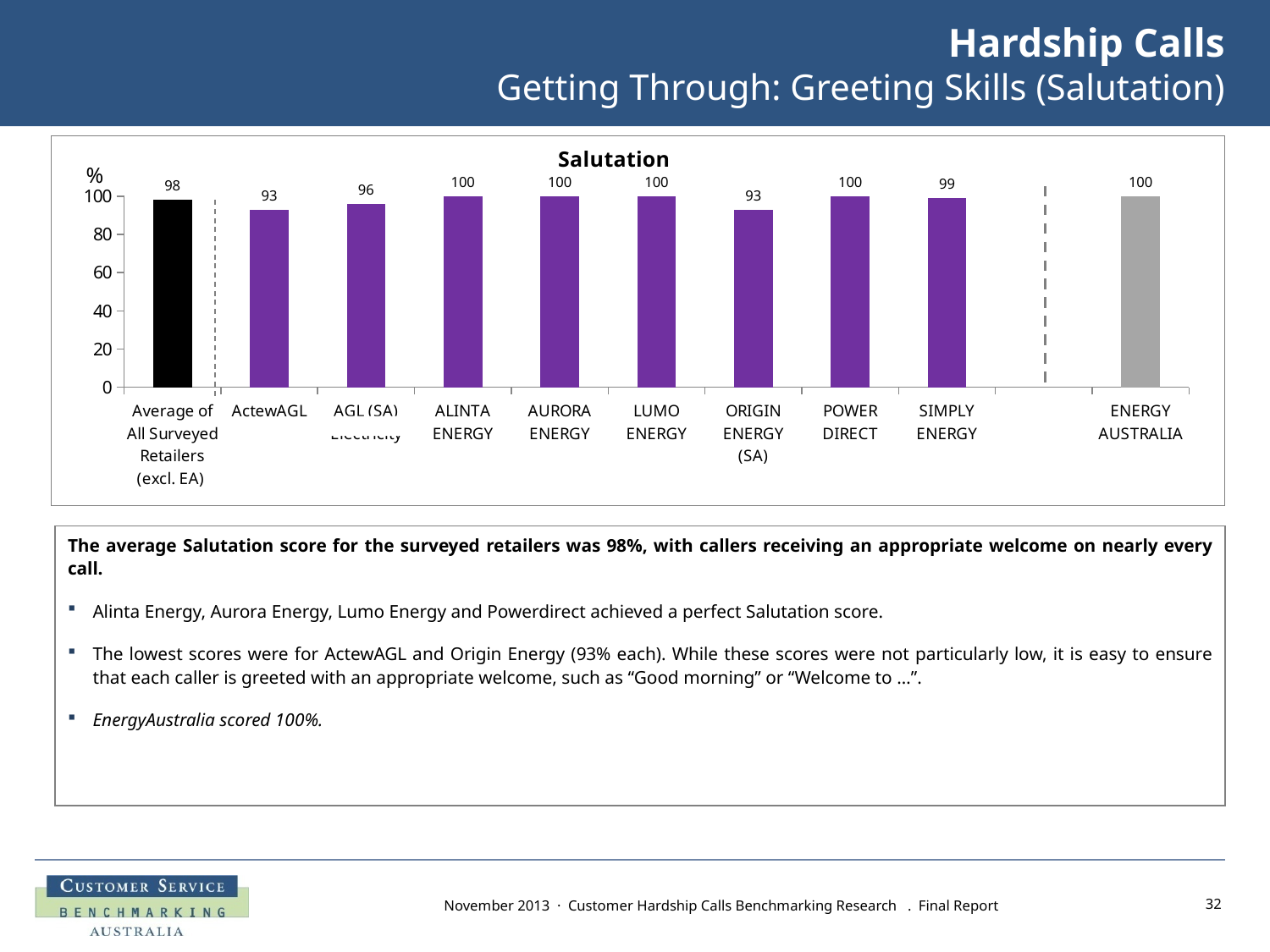
What is the title of the chart? Salutation What is the value shown for the Average of All Surveyed Retailers (excl. EA)? 98 What is the Salutation score for Energy Australia? 100 What is the Salutation score for Simply Energy? 99 What is the Salutation score for Origin Energy (SA)? 93 What is the difference between the Salutation scores of Alinta Energy and ActewAGL? 7 Which has a higher Salutation score, Simply Energy or Origin Energy (SA)? Simply Energy Which has a higher Salutation score, Power Direct or ActewAGL? Power Direct What is the difference between the Average of All Surveyed Retailers (excl. EA) and Simply Energy? 1 How many bars are plotted in the Salutation chart? 10 What type of chart is shown on the slide? Bar chart What is the Salutation score for ActewAGL? 93